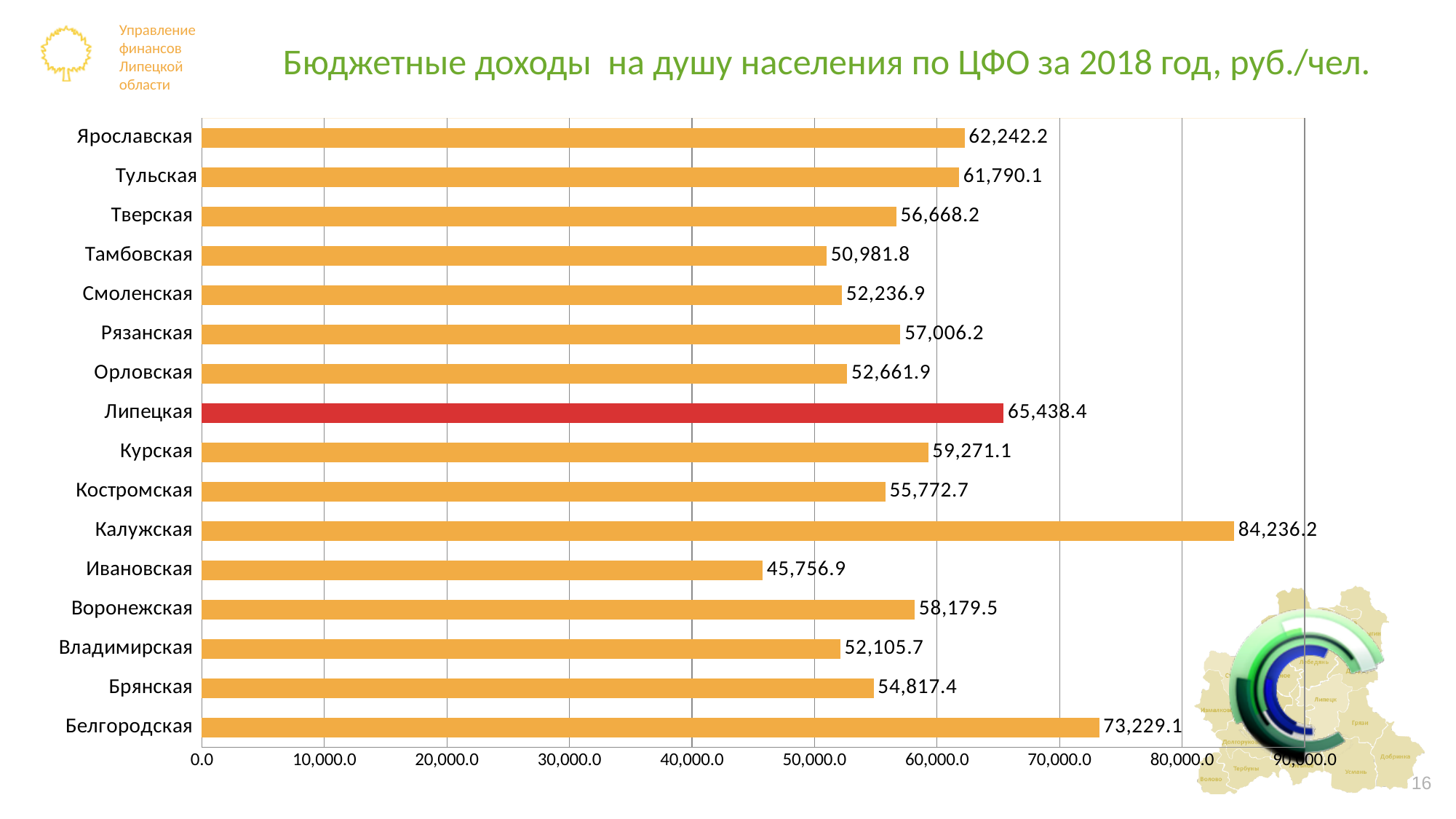
Which region has the lowest value? Ивановская Is the value for Ивановская greater or less than 50,000.0? less Which region has the highest value? Калужская How many regions are shown in the chart? 16 What is the difference between the values for Белгородская and Липецкая? 7,790.7 What is the value for Липецкая? 65,438.4 What kind of chart is shown on the slide? bar chart What is the value for Ивановская? 45,756.9 What is the difference between the values for Калужская and Липецкая? 18,797.8 What is the value for Белгородская? 73,229.1 Which is larger, the value for Липецкая or the value for Белгородская? Белгородская What is the value for Калужская? 84,236.2